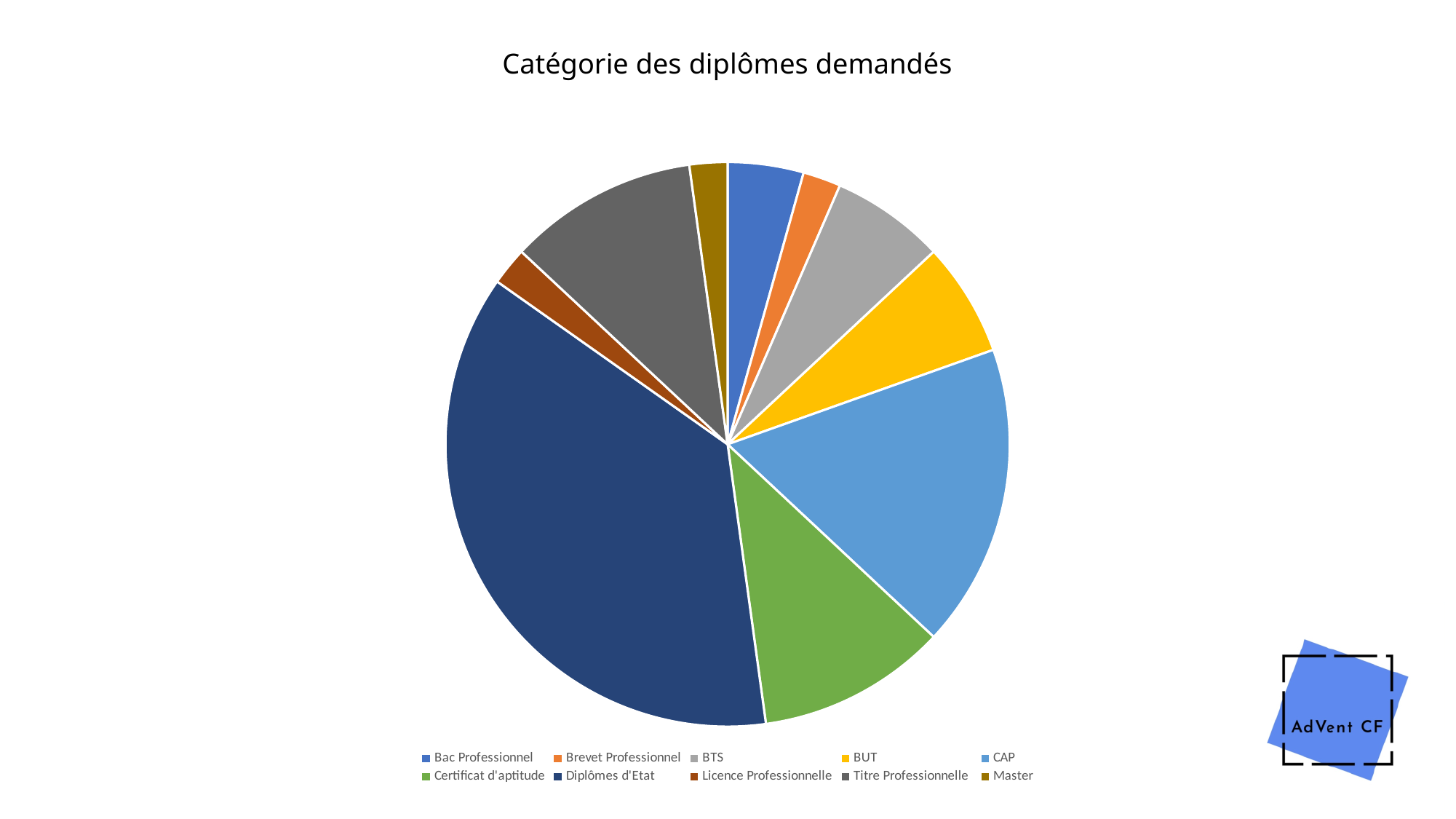
Which is larger, the slice for BTS or the slice for Brevet Professionnel? BTS Which is larger, the slice for Certificat d'aptitude or the slice for Master? Certificat d'aptitude Which category has the largest slice of the pie? Diplômes d'Etat What is the title of the chart? Catégorie des diplômes demandés Which is larger, the slice for Titre Professionnelle or the slice for BUT? Titre Professionnelle Which category is shown in yellow in the pie chart? BUT How many categories does the pie chart have? 10 What kind of chart is shown on the slide? pie chart